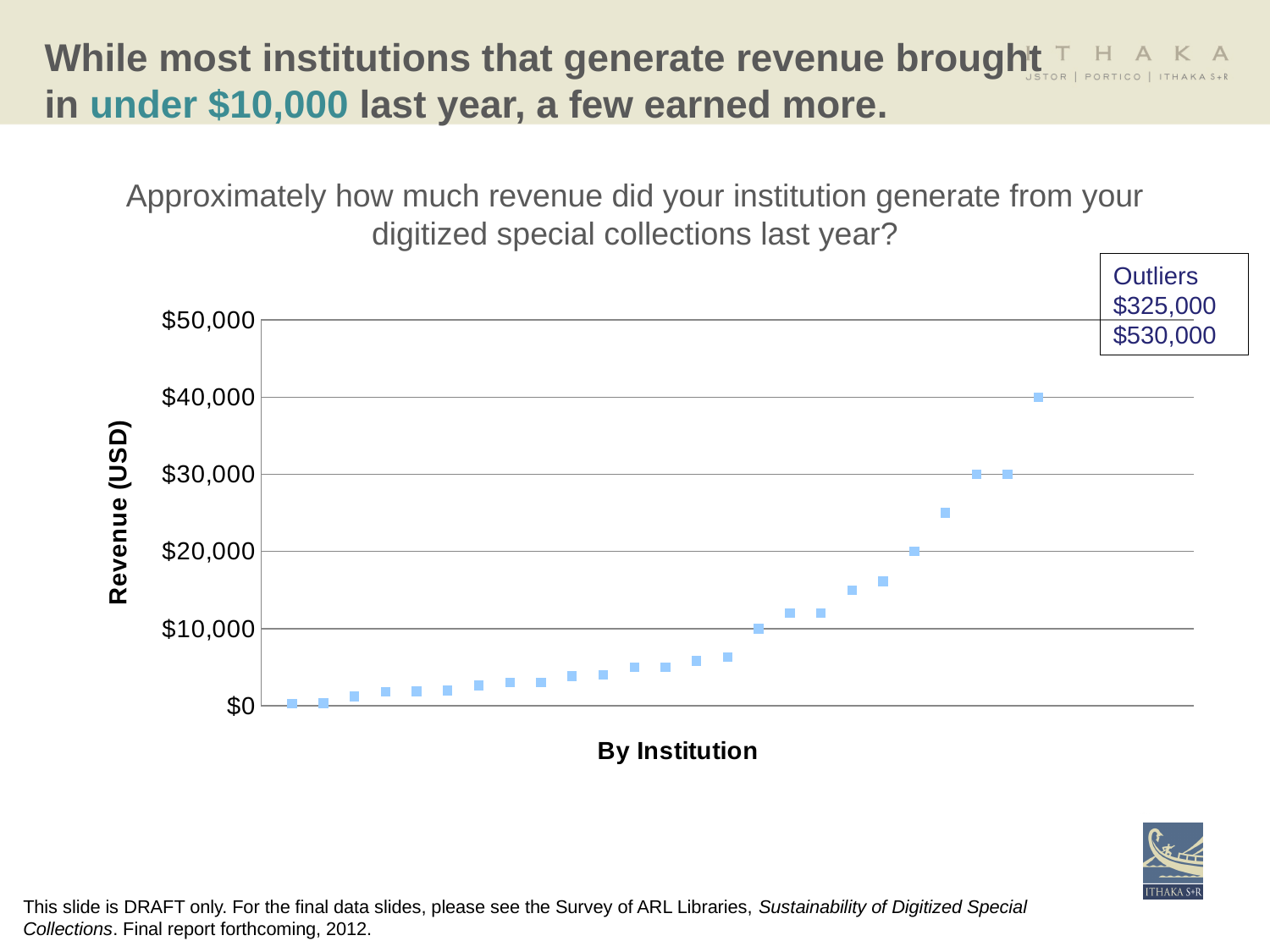
Which of the two outliers listed in the box is larger? $530,000 What is the highest value shown on the vertical axis? $50,000 Is the value of the leftmost plotted point greater or less than $10,000? less Do the plotted revenue values rise or fall from left to right along the x axis? Rise What kind of chart is shown on the slide? Scatter chart What is the label of the horizontal axis? By Institution What is the value of the highest plotted point on the chart (excluding the outliers listed in the box)? $40,000 Is the value of the rightmost plotted point greater or less than $30,000? greater What are the two outlier values listed in the box on the chart? $325,000 and $530,000 What is the label of the vertical axis? Revenue (USD) How many institutions are plotted as points on the chart? 25 What is the difference between the two outlier values listed in the box? $205,000